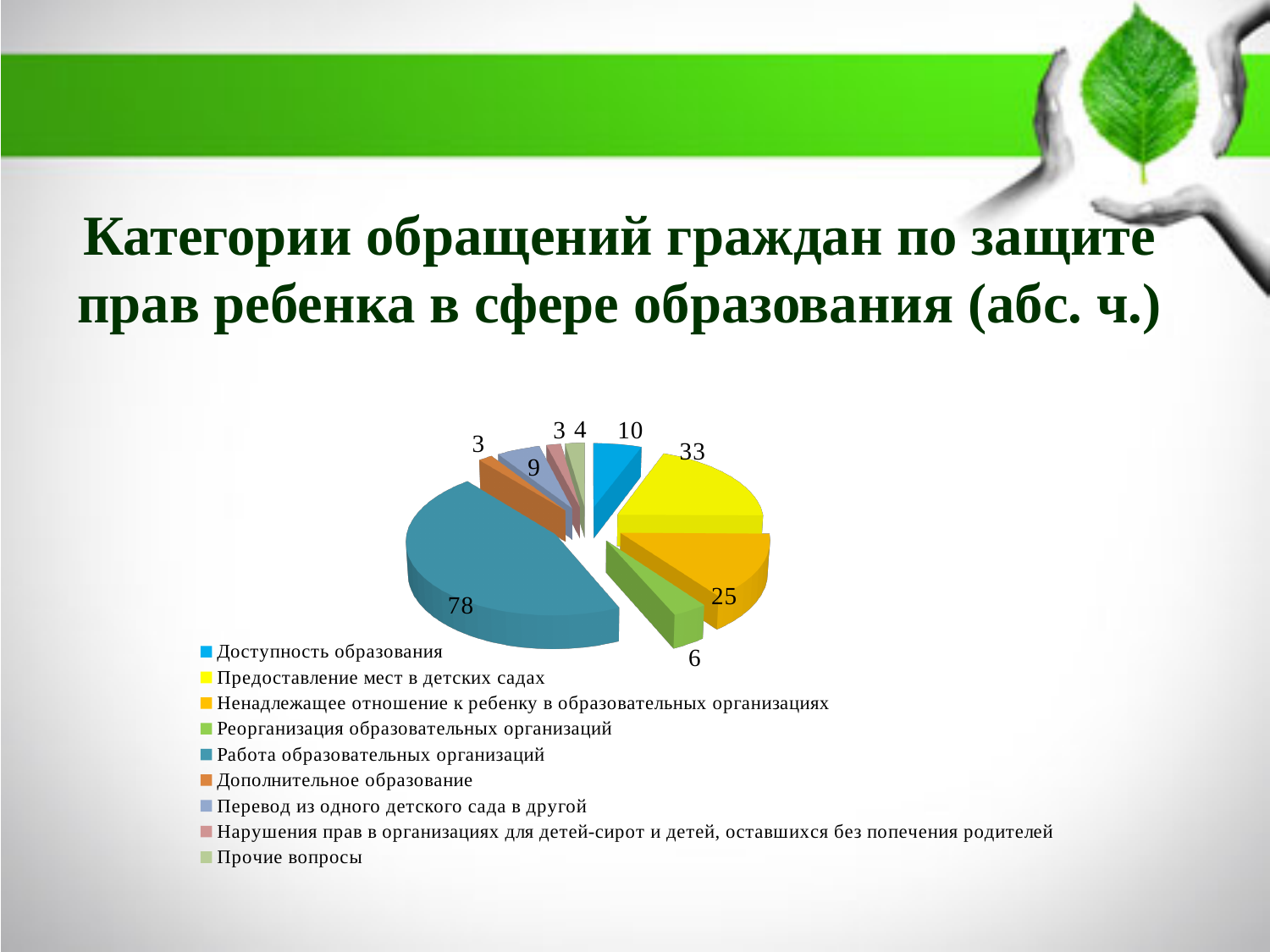
What is the value for Предоставление мест в детских садах? 33 What is the value for Работа образовательных организаций? 78 What is the total of all the values shown on the pie chart? 171 What is the difference between the values for Работа образовательных организаций and Предоставление мест в детских садах? 45 Which category has the largest slice of the pie? Работа образовательных организаций What colour is the slice for Предоставление мест в детских садах? Yellow What is the value for Доступность образования? 10 What is the value for Реорганизация образовательных организаций? 6 What is the value for Ненадлежащее отношение к ребенку в образовательных организациях? 25 How many categories does the legend list? 9 Which is larger: the value for Ненадлежащее отношение к ребенку в образовательных организациях or the value for Доступность образования? Ненадлежащее отношение к ребенку в образовательных организациях What type of chart is shown on the slide? Pie chart